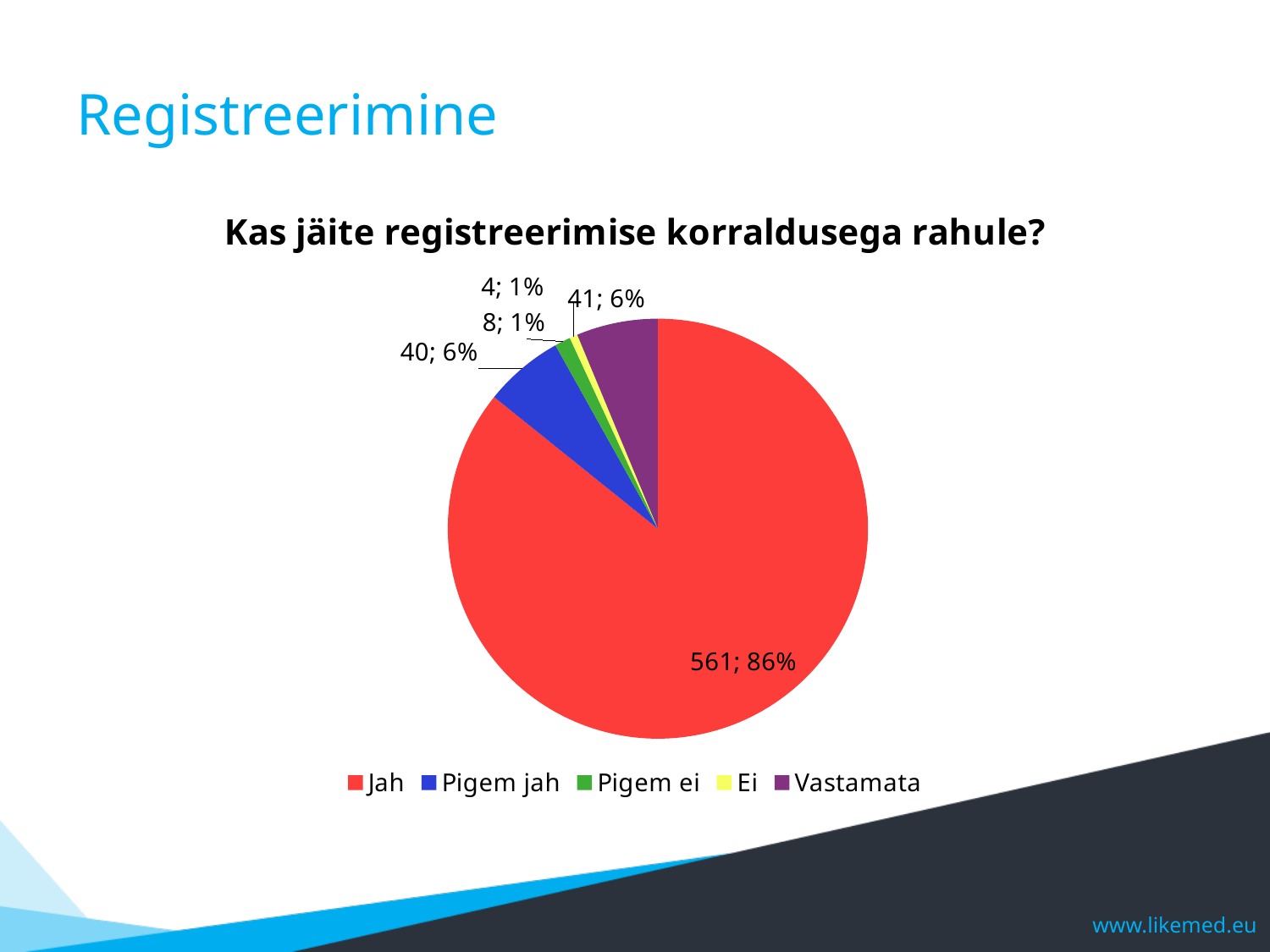
Which category has the smallest slice? Ei How many slices does the pie chart have? 5 Which category has the largest slice? Jah What is the difference between the counts for 'Jah' and 'Vastamata'? 520 What percentage share does the 'Pigem ei' slice have? 1% What kind of chart is shown on the slide? pie chart What percentage share does the 'Jah' slice have? 86% What is the title of the chart? Kas jäite registreerimise korraldusega rahule? What is the count shown for the 'Pigem jah' slice? 40 How many entries does the legend list? 5 What is the count shown for the 'Vastamata' slice? 41 What is the count shown for the 'Jah' slice? 561